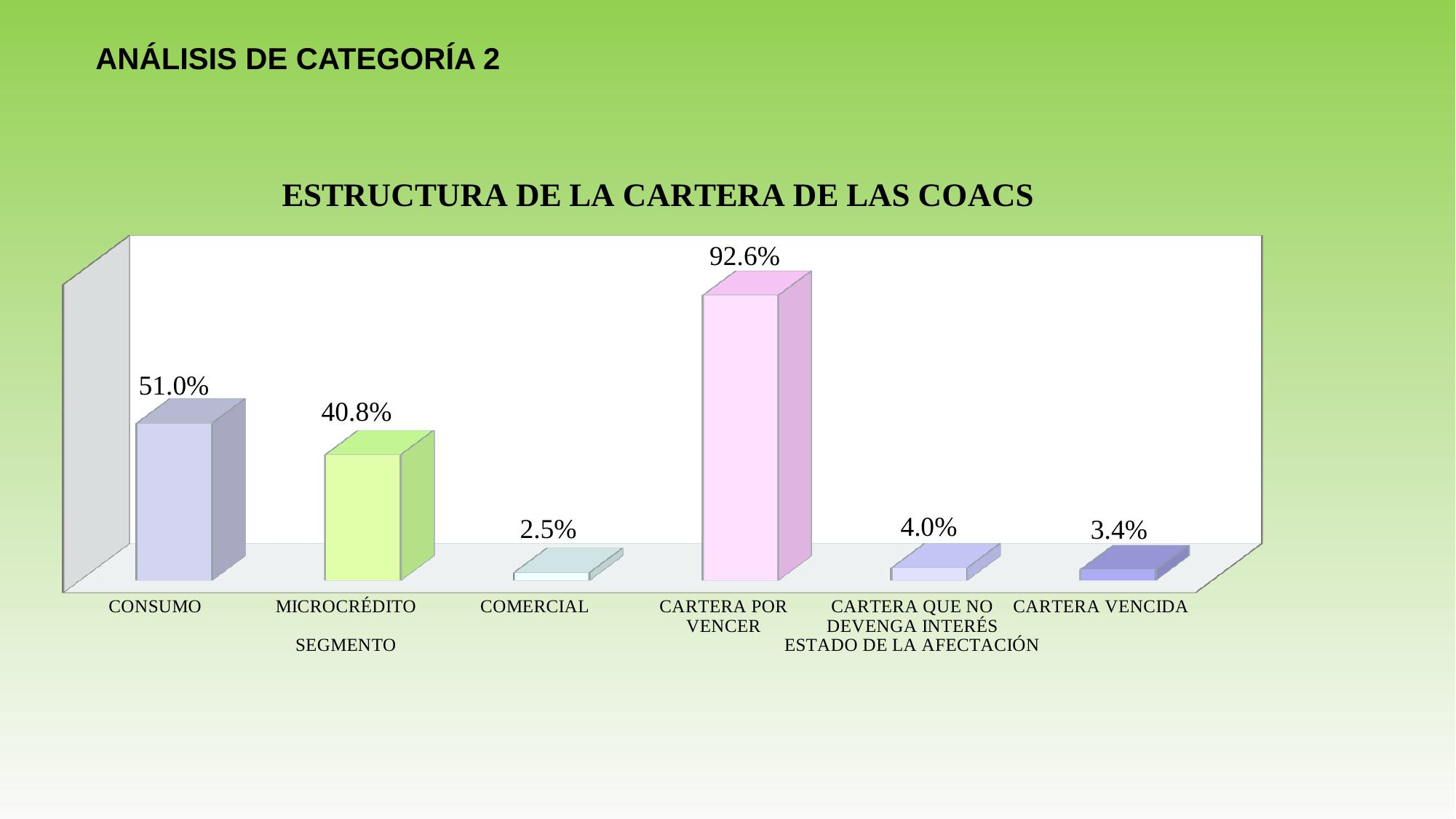
What is the value for CARTERA QUE NO DEVENGA INTERÉS? 4.0% What is the title of the chart? ESTRUCTURA DE LA CARTERA DE LAS COACS Which is larger, the value for CARTERA QUE NO DEVENGA INTERÉS or CARTERA VENCIDA? CARTERA QUE NO DEVENGA INTERÉS What is the value for MICROCRÉDITO? 40.8% Which category has the lowest value? COMERCIAL What is the difference between the values for CONSUMO and MICROCRÉDITO? 10.2% What is the value for CONSUMO? 51.0% Which category has the highest value? CARTERA POR VENCER What is the value for CARTERA POR VENCER? 92.6% How many categories are shown in the chart? 6 What is the value for COMERCIAL? 2.5% What is the value for CARTERA VENCIDA? 3.4%